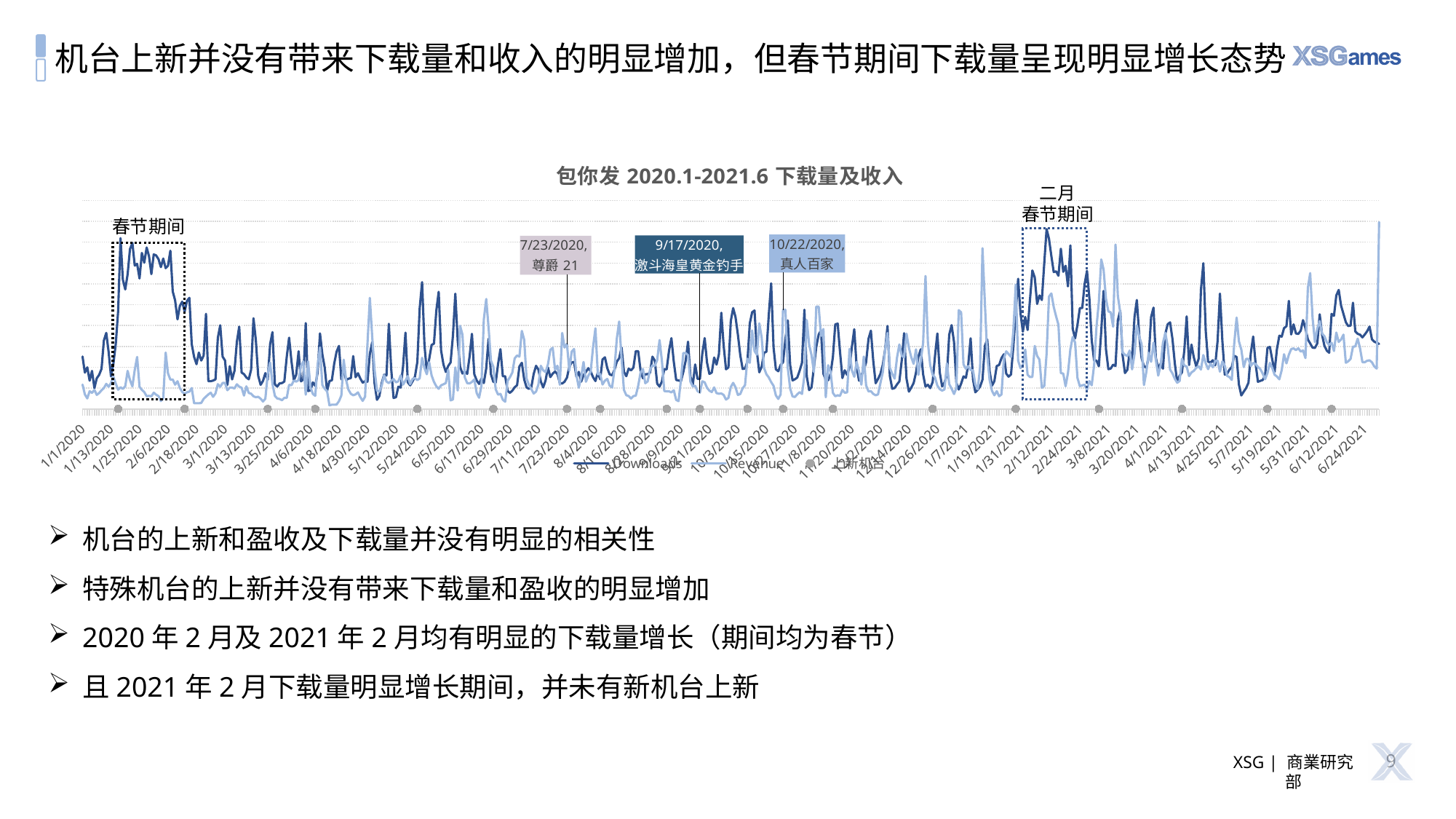
What is the first date shown on the x axis of the chart? 1/1/2020 What is the last date shown on the x axis of the chart? 6/24/2021 How many dotted-box highlighted periods are marked on the chart? 2 On what date does the chart annotation mark the launch of 激斗海皇黄金钓手? 9/17/2020 Which machine does the chart annotation show as launched on 10/22/2020? 真人百家 What kind of chart is shown on the slide? line chart On what date does the chart annotation mark the launch of 尊爵 21? 7/23/2020 How many series does the chart legend list? 3 What is the title of the chart? 包你发 2020.1-2021.6 下载量及收入 How many machine launches are annotated with labelled boxes on the chart? 3 What label is given to the dotted box at the left of the chart in early 2020? 春节期间 Within the early-2020 春节期间 dotted box, which series is higher, Downloads or Revenue? Downloads